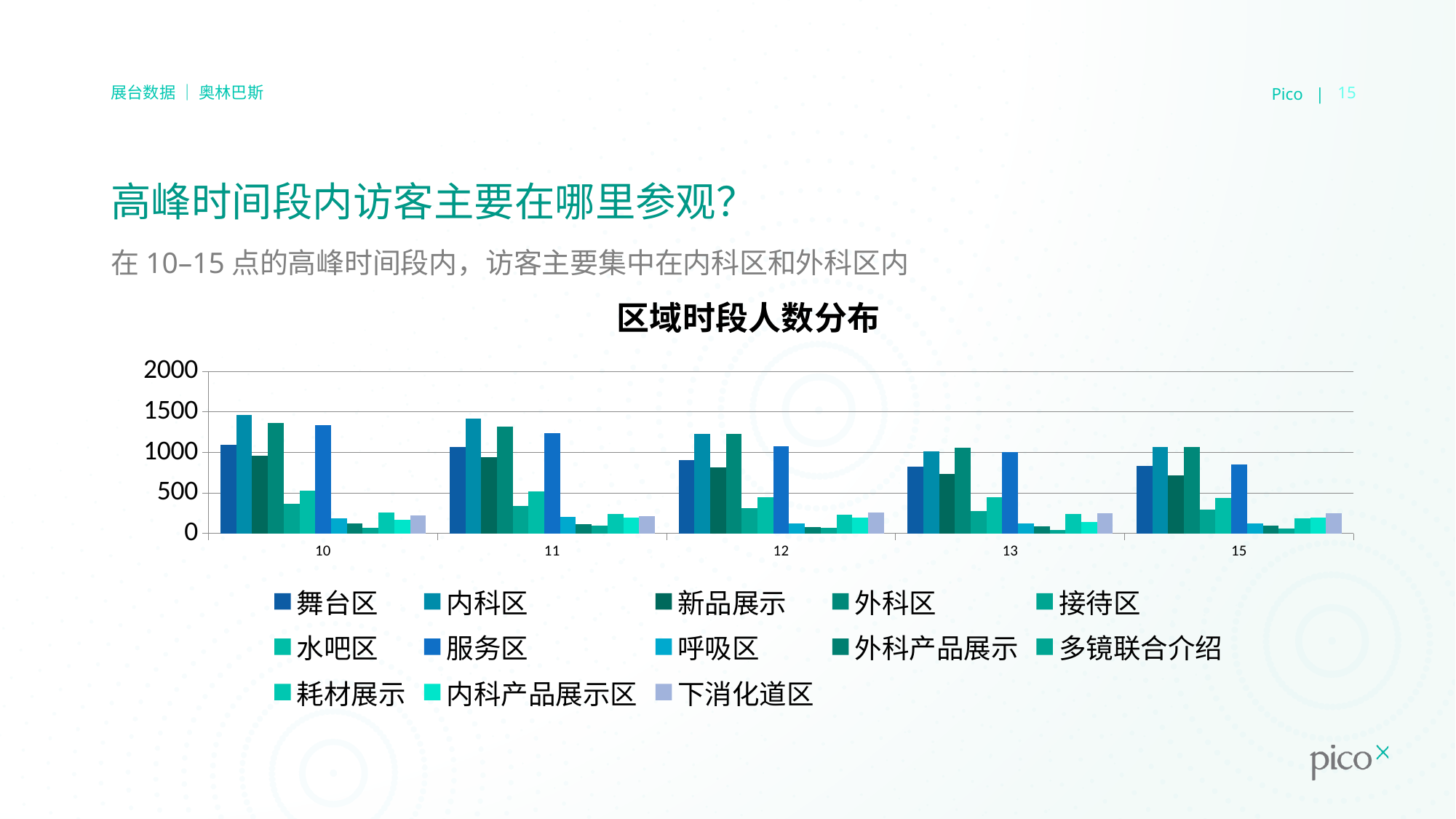
How many time-slot categories are shown on the x axis? 5 Is the value for 服务区 at hour 15 greater or less than 1000? less Does the value for 服务区 rise or fall from hour 10 to hour 15? Fall Is the value for 下消化道区 at hour 15 greater or less than 500? less Is the value for 舞台区 at hour 13 greater or less than 1000? less Which series is shown in light purple in the legend? 下消化道区 What is the title of the chart? 区域时段人数分布 What kind of chart is shown on the slide? Bar chart How many series does the legend list? 13 At hour 10, which series has the lowest value? 多镜联合介绍 At hour 10, which is larger: 舞台区 or 服务区? 服务区